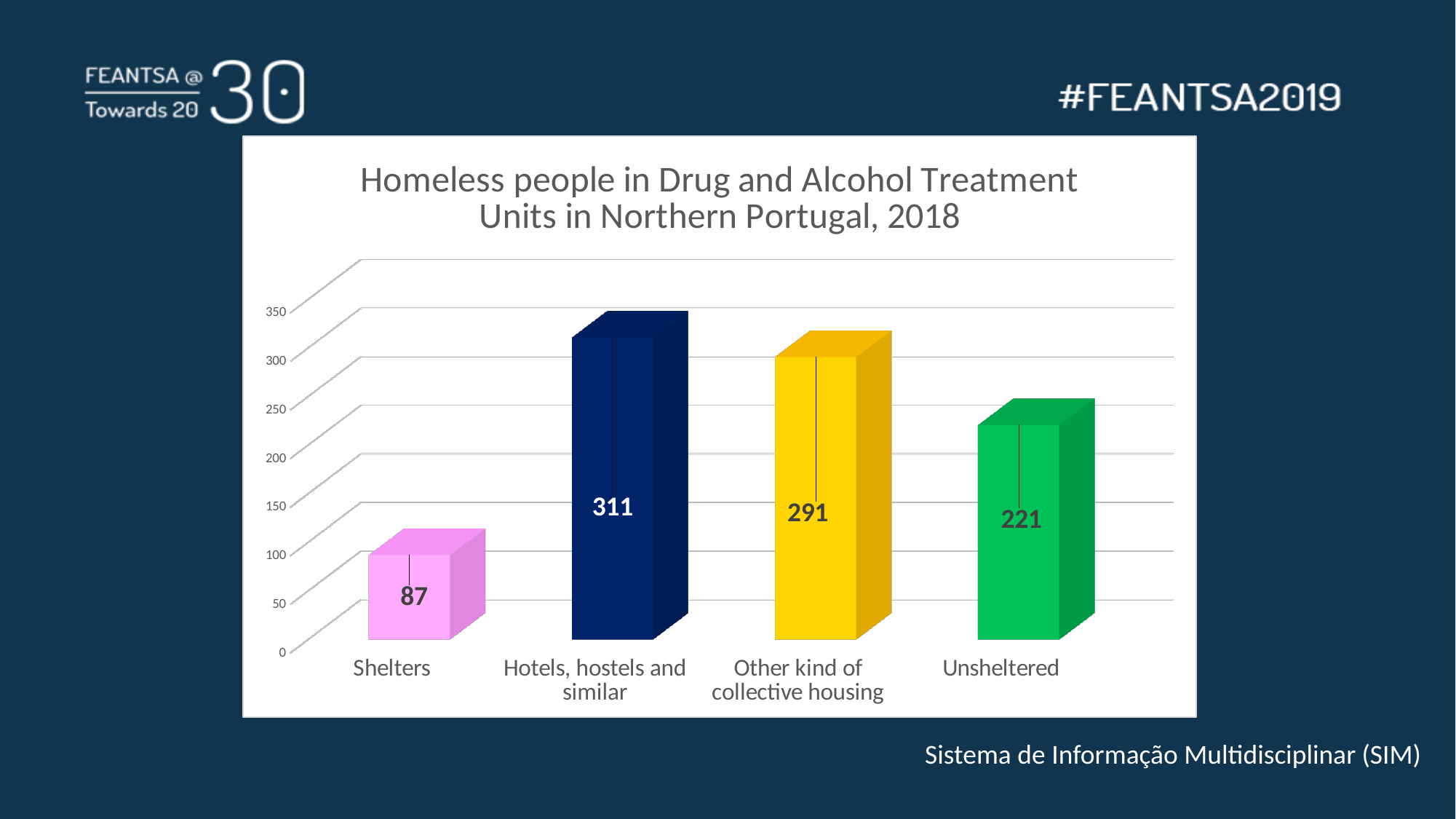
Which is larger, the value for Unsheltered or the value for Shelters? Unsheltered What is the value for Other kind of collective housing? 291 Which category has the highest value? Hotels, hostels and similar What is the value for Hotels, hostels and similar? 311 Which category has the lowest value? Shelters What is the difference between the values for Other kind of collective housing and Unsheltered? 70 What is the title of the chart? Homeless people in Drug and Alcohol Treatment Units in Northern Portugal, 2018 What is the difference between the values for Hotels, hostels and similar and Shelters? 224 What is the value for Shelters? 87 What is the value for Unsheltered? 221 How many categories are shown on the chart? 4 What kind of chart is shown on the slide? Bar chart